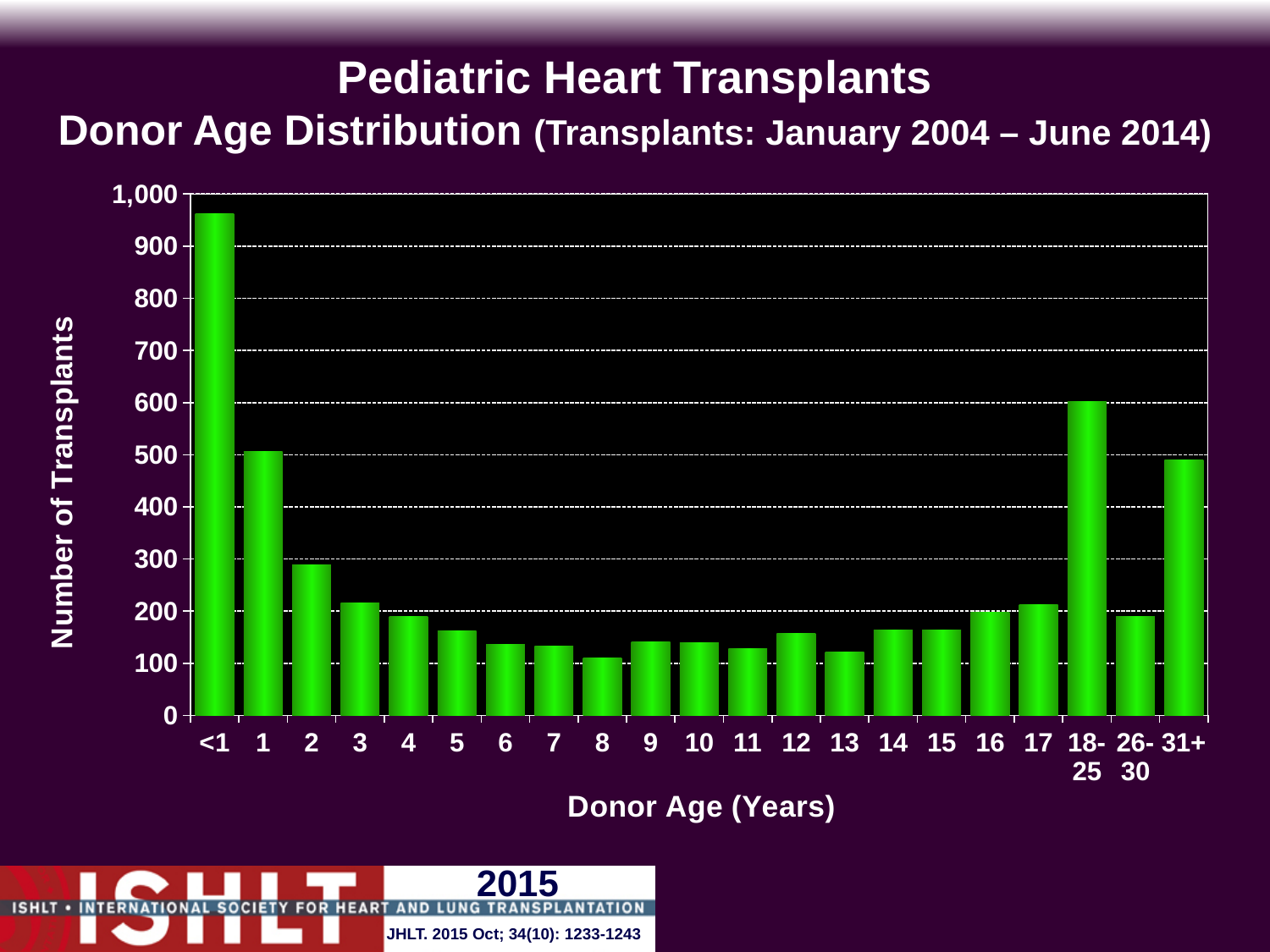
Which donor age category has the highest number of transplants? <1 Which has more transplants: donor age <1 or donor age 18-25? <1 Is the number of transplants for donor age 8 greater or less than 200? less Is the number of transplants for donor age 31+ greater or less than 400? greater Do the number of transplants rise or fall as donor age goes from 1 to 8 years? fall What type of chart is shown on the slide? bar chart How many donor age categories are shown on the x axis? 21 Is the number of transplants for donor age 1 greater or less than 600? less Which has more transplants: donor age 18-25 or donor age 31+? 18-25